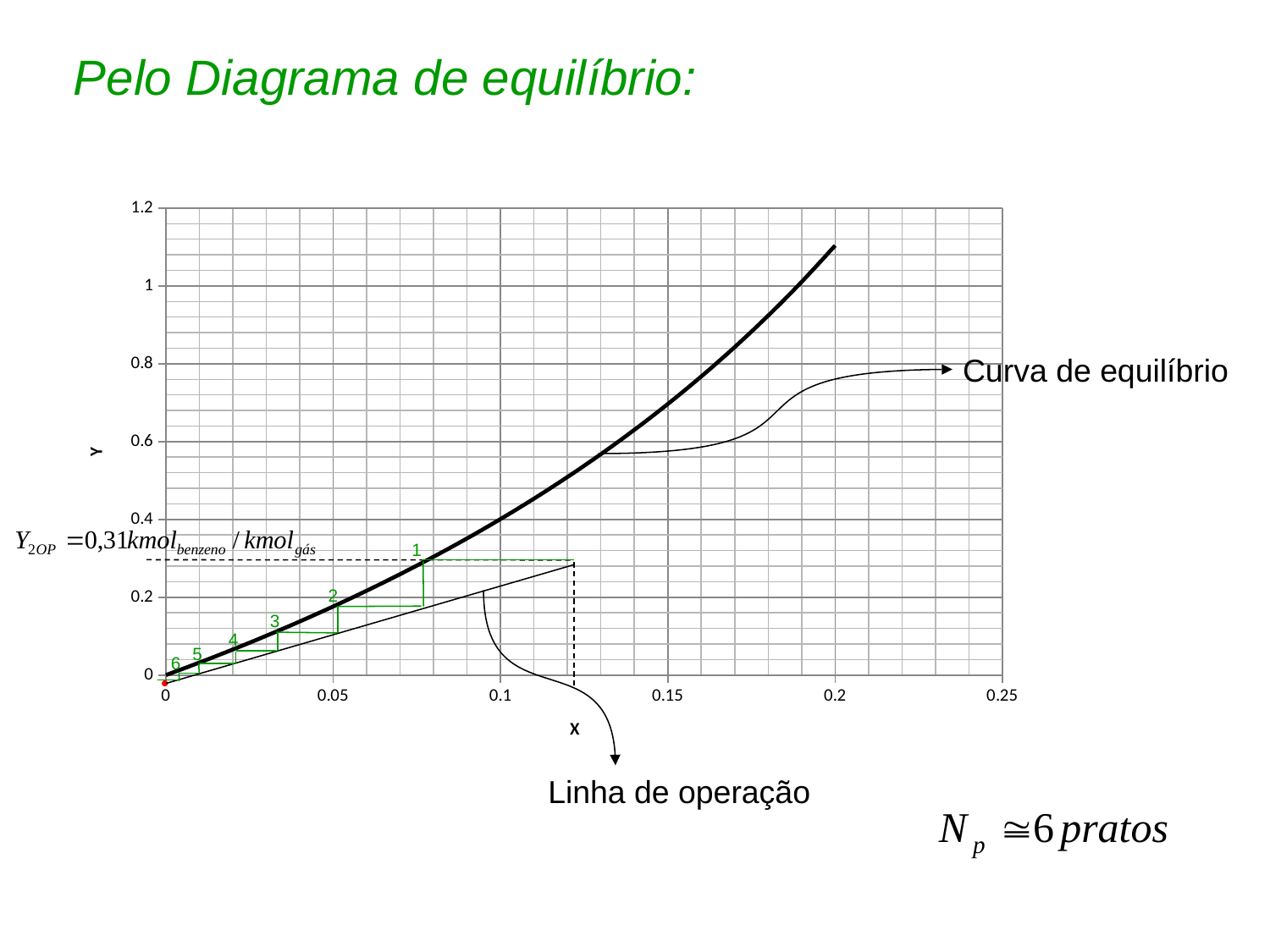
Is the value of the equilibrium curve at X = 0.1 greater or less than 0.6? less According to the annotation on the slide, how many pratos (stages) are required? 6 pratos What is the highest tick value shown on the Y axis? 1.2 What kind of chart is shown on the slide? line chart Does the equilibrium curve rise or fall as X increases? rise Is the value of the equilibrium curve at X = 0.2 greater or less than 1? greater At X = 0.1, which line has the higher Y value, the equilibrium curve or the operating line? equilibrium curve Is the value of the equilibrium curve at X = 0.15 greater or less than 0.6? greater How many stages (green steps) are numbered between the equilibrium curve and the operating line? 6 What value of Y2OP is given in the annotation on the chart? 0,31 kmol benzeno / kmol gás What is the label of the thick curved line in the chart? Curva de equilíbrio What is the label of the thin straight line in the chart? Linha de operação